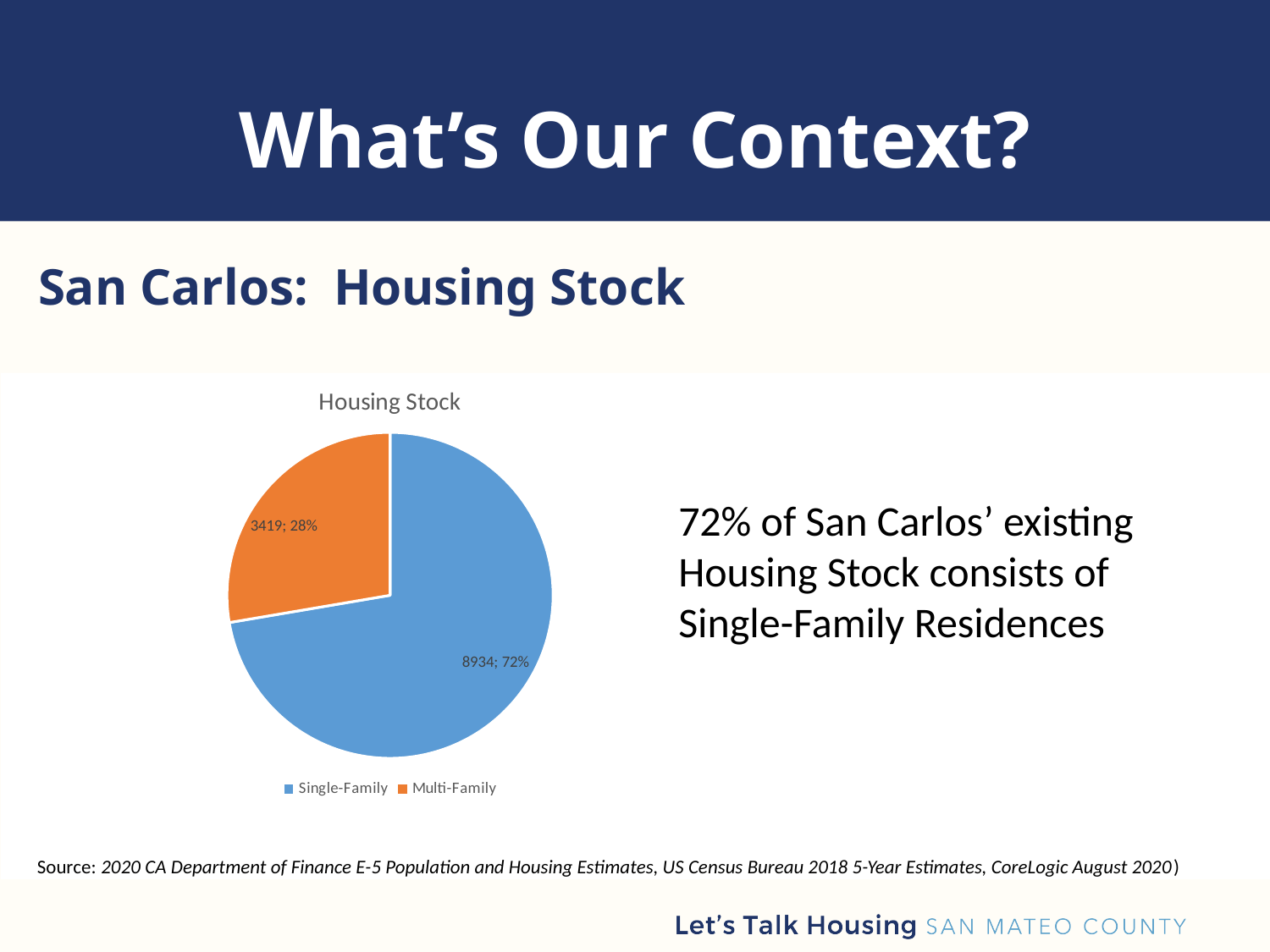
What is the title of the chart? Housing Stock How many slices does the pie chart have? 2 Which category has the smallest slice? Multi-Family What is the value for Single-Family? 8934 Which colour represents Multi-Family in the chart? orange What is the value for Multi-Family? 3419 What is the difference between the Single-Family and Multi-Family values? 5515 What share of the pie is Single-Family? 72% Which category has the largest slice? Single-Family What share of the pie is Multi-Family? 28% How many entries does the legend list? 2 What kind of chart is shown on the slide? pie chart